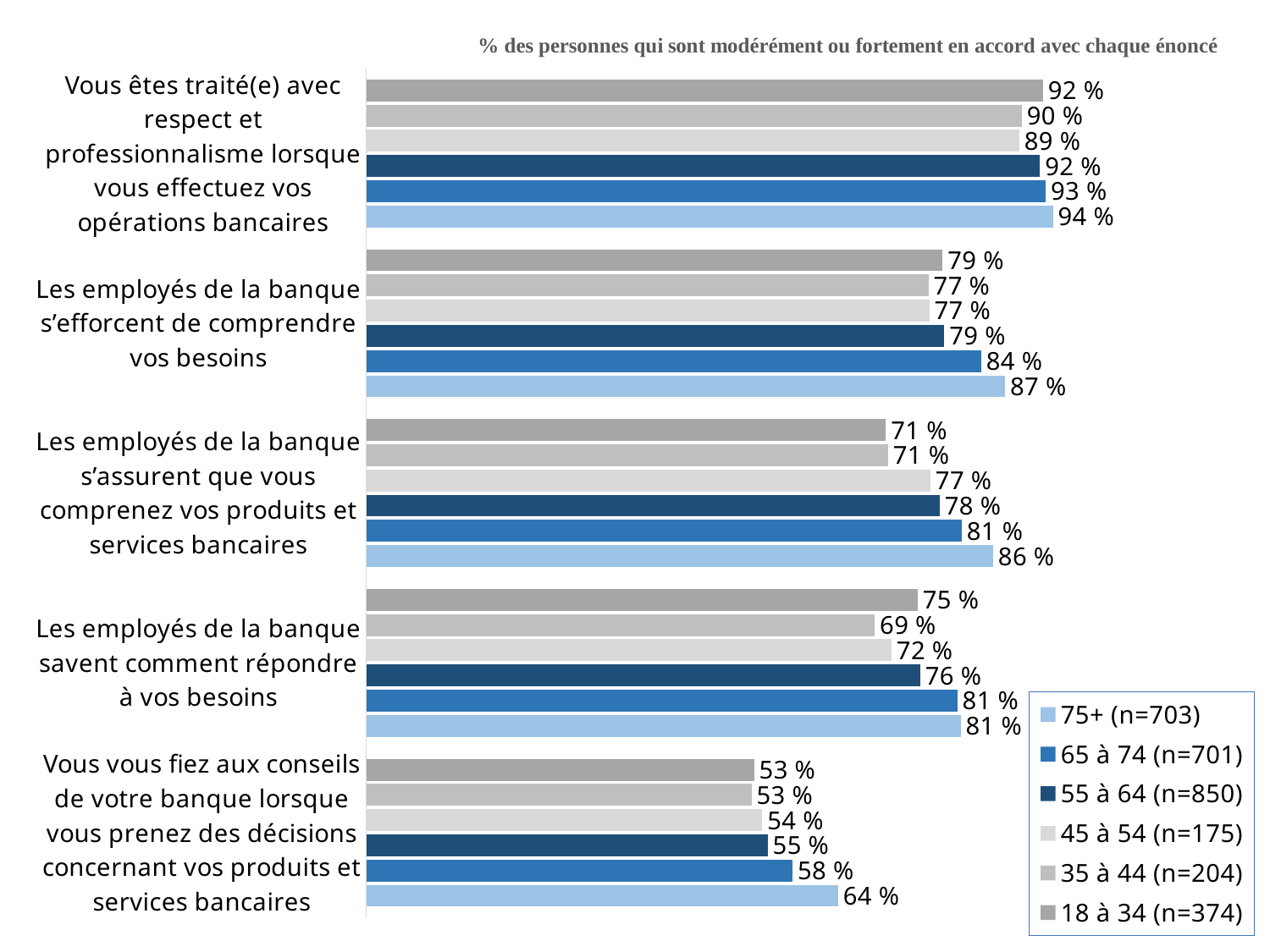
What is the value for the 18 à 34 (n=374) group on the statement "Vous vous fiez aux conseils de votre banque lorsque vous prenez des décisions concernant vos produits et services bancaires"? 53 % How many series does the legend list? 6 Which age group has the lowest value for the statement "Les employés de la banque savent comment répondre à vos besoins"? 35 à 44 (n=204) What kind of chart is shown on the slide? bar chart What is the difference between the 75+ (n=703) and 18 à 34 (n=374) values for the statement "Vous vous fiez aux conseils de votre banque lorsque vous prenez des décisions concernant vos produits et services bancaires"? 11 % What is the subtitle text shown at the top of the chart? % des personnes qui sont modérément ou fortement en accord avec chaque énoncé For the statement "Les employés de la banque s'assurent que vous comprenez vos produits et services bancaires", which is larger: the value for 45 à 54 (n=175) or the value for 35 à 44 (n=204)? 45 à 54 (n=175) What is the value for the 65 à 74 (n=701) group on the statement "Les employés de la banque s'efforcent de comprendre vos besoins"? 84 % Which age group has the highest value for the statement "Les employés de la banque s'assurent que vous comprenez vos produits et services bancaires"? 75+ (n=703) How many statements (categories) are plotted on the chart? 5 What is the value for the 75+ (n=703) group on the statement "Vous êtes traité(e) avec respect et professionnalisme lorsque vous effectuez vos opérations bancaires"? 94 % What is the sample size shown in the legend for the 55 à 64 group? n=850